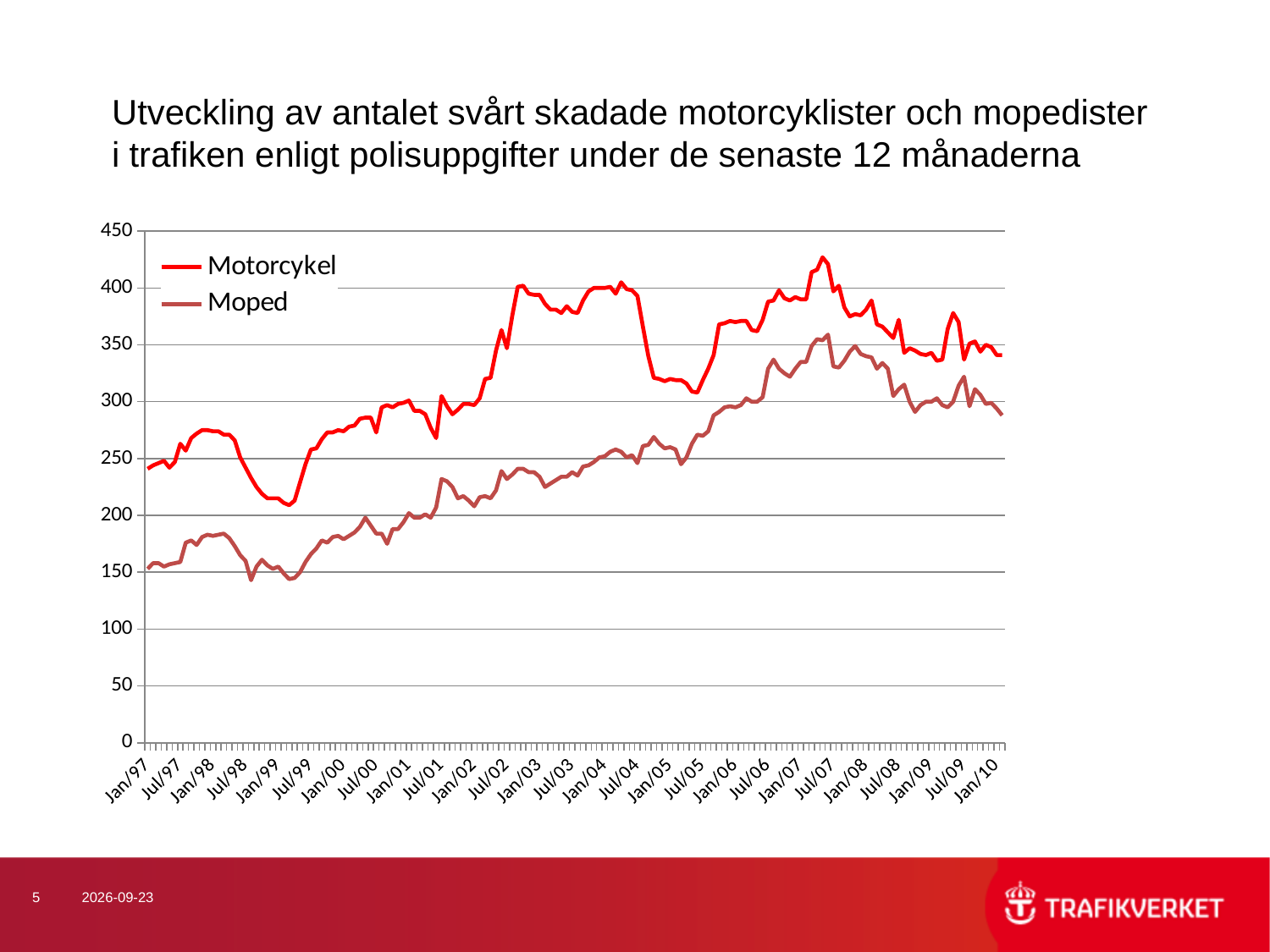
Does the Motorcykel line generally rise or fall from Jul/07 to Jan/10? Fall What kind of chart is shown on the slide? Line chart Is the peak value of the Motorcykel line greater or less than 400? greater At Jan/05, which series has the larger value, Motorcykel or Moped? Motorcykel Which two series are listed in the legend? Motorcykel and Moped Does the Moped line generally rise or fall from Jan/97 to Jan/07? Rise Is the value for Moped at Jan/97 greater or less than 200? less Is the value for Moped at Jan/10 greater or less than 300? less How many series does the legend list? 2 What is the highest value shown on the y axis? 450 Which series reaches the highest value on the chart? Motorcykel